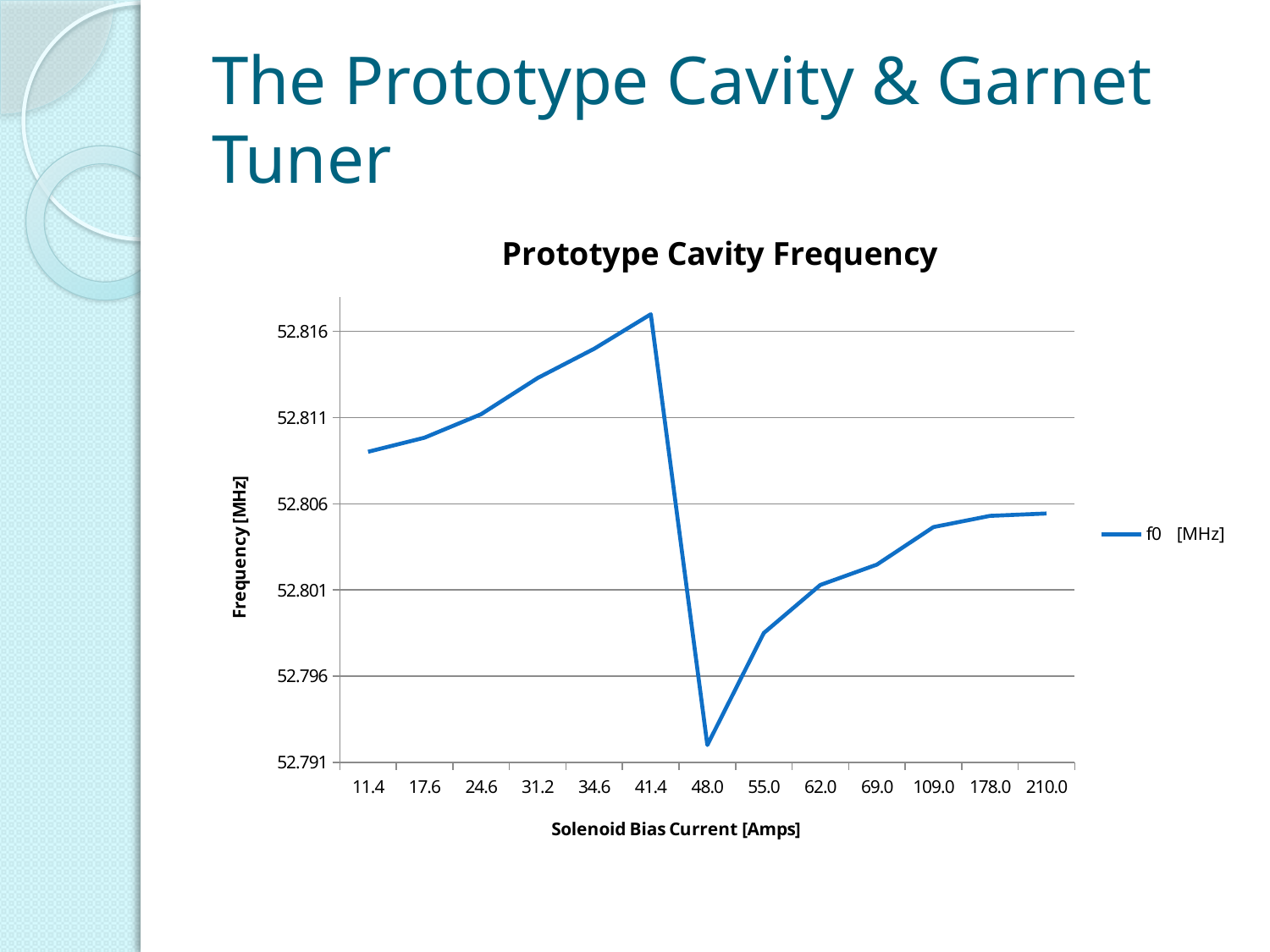
How many solenoid bias current values are plotted along the x axis? 13 Which has the higher frequency, 17.6 Amps or 55.0 Amps? 17.6 Amps Is the frequency at 11.4 Amps greater or less than 52.806? greater Is the frequency at 31.2 Amps greater or less than 52.811? greater Does the frequency rise or fall from 48.0 Amps to 210.0 Amps? rise What kind of chart is shown on the slide? line chart At which solenoid bias current is the frequency lowest? 48.0 What is the title of the chart? Prototype Cavity Frequency Is the frequency at 55.0 Amps greater or less than 52.801? less At which solenoid bias current is the frequency highest? 41.4 How many series does the legend list? 1